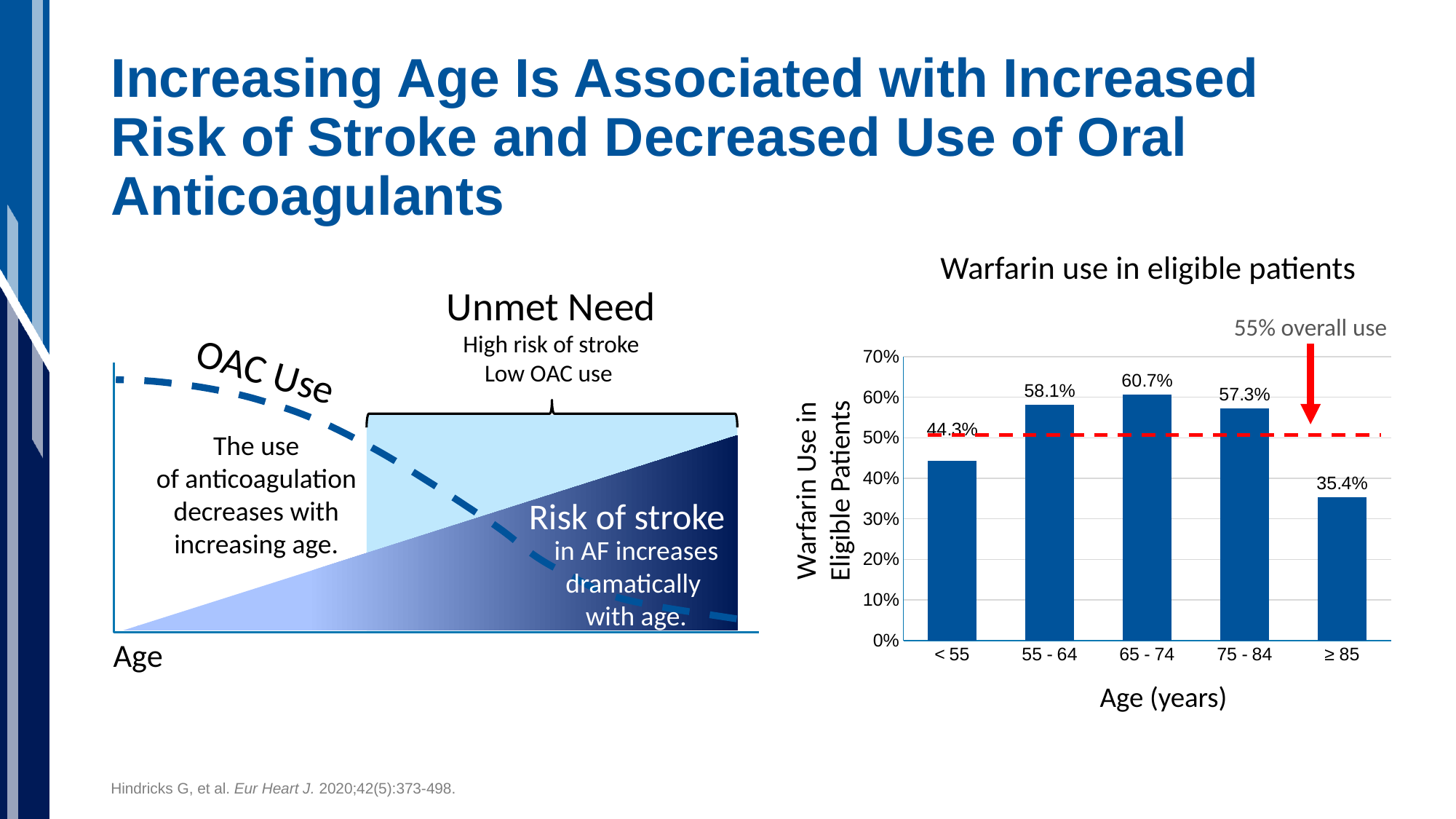
What type of chart is 'Warfarin use in eligible patients'? bar chart In the bar chart 'Warfarin use in eligible patients', what is the difference in warfarin use between the 65 - 74 group and the ≥ 85 group? 25.3 percentage points In the bar chart 'Warfarin use in eligible patients', what is the warfarin use for the 65 - 74 age group? 60.7% In the bar chart 'Warfarin use in eligible patients', which age group has the highest warfarin use? 65 - 74 In the bar chart 'Warfarin use in eligible patients', what does the red dashed line represent? 55% overall use In the bar chart 'Warfarin use in eligible patients', what is the warfarin use for the < 55 age group? 44.3% In the bar chart 'Warfarin use in eligible patients', which has higher warfarin use: the 55 - 64 group or the 75 - 84 group? 55 - 64 In the bar chart 'Warfarin use in eligible patients', what is the warfarin use for patients aged ≥ 85? 35.4% In the bar chart 'Warfarin use in eligible patients', is the value for the < 55 group greater or less than 50%? less In the bar chart 'Warfarin use in eligible patients', does warfarin use rise or fall from the 75 - 84 group to the ≥ 85 group? fall In the bar chart 'Warfarin use in eligible patients', which age group has the lowest warfarin use? ≥ 85 How many age groups are shown in the bar chart 'Warfarin use in eligible patients'? 5